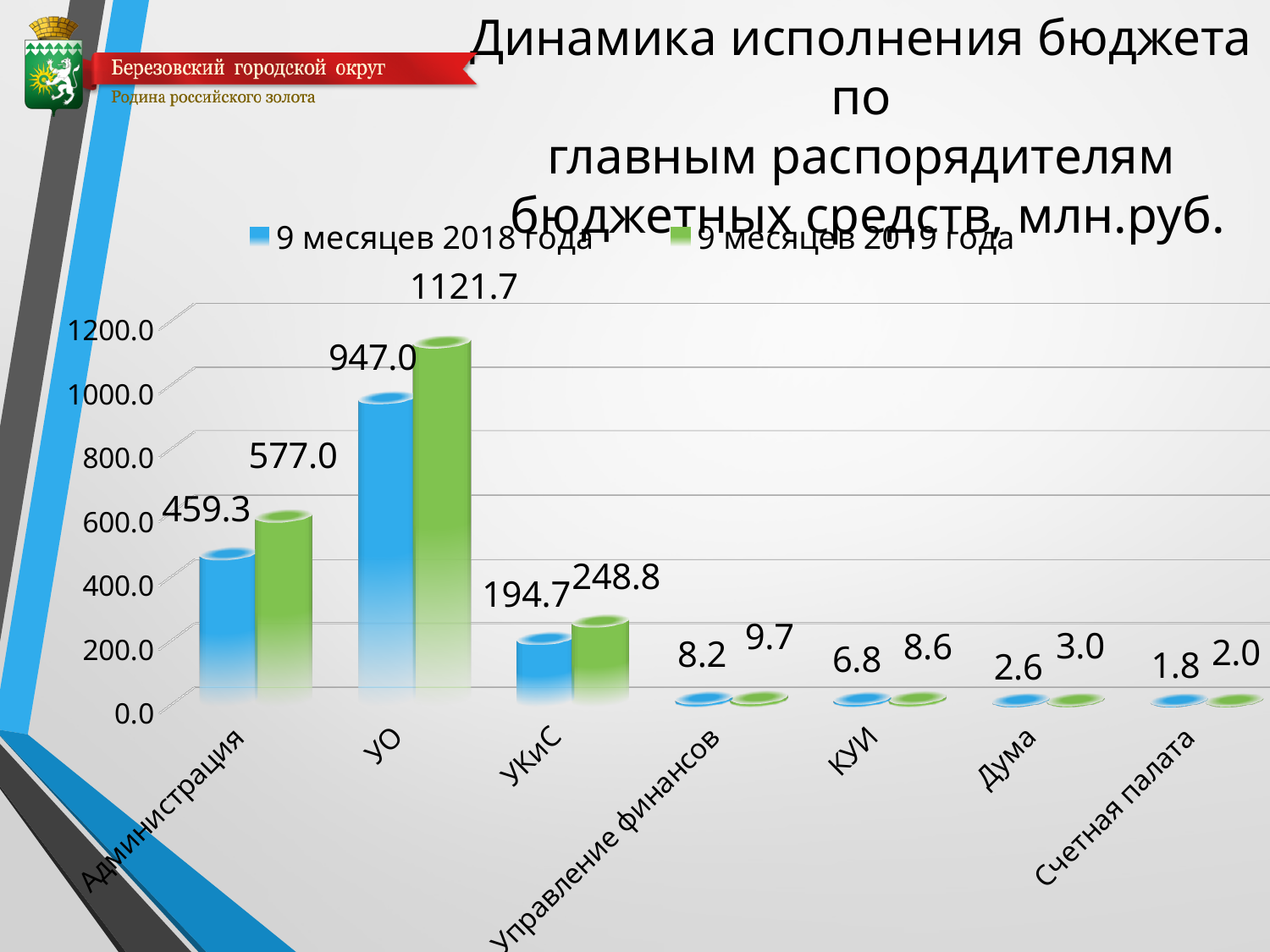
What is the value for Администрация in the series 9 месяцев 2018 года? 459.3 What is the difference between the 9 месяцев 2019 года and 9 месяцев 2018 года values for УО? 174.7 Which category has the lowest value in the series 9 месяцев 2018 года? Счетная палата How many categories are shown on the x axis? 7 What is the value for УО in the series 9 месяцев 2019 года? 1121.7 What is the difference between the 9 месяцев 2019 года and 9 месяцев 2018 года values for Администрация? 117.7 Which is larger for Дума: the 9 месяцев 2018 года value or the 9 месяцев 2019 года value? 9 месяцев 2019 года What kind of chart is shown on the slide? bar chart What is the value for УКиС in the series 9 месяцев 2019 года? 248.8 How many series does the legend list? 2 Which category has the highest value in the series 9 месяцев 2019 года? УО What is the value for КУИ in the series 9 месяцев 2018 года? 6.8